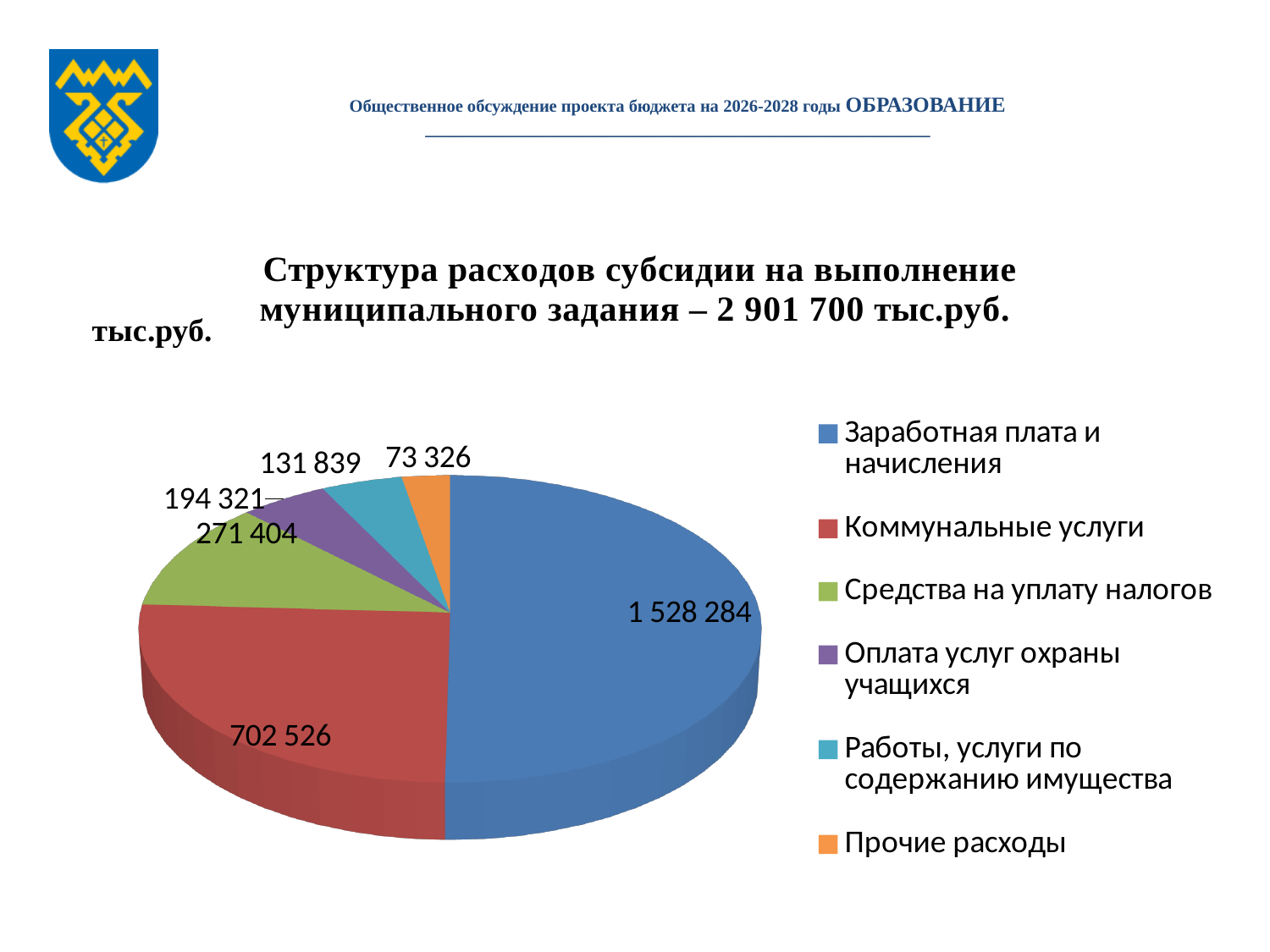
What is the difference between Заработная плата и начисления and Коммунальные услуги? 825 758 Which is larger: Оплата услуг охраны учащихся or Работы, услуги по содержанию имущества? Оплата услуг охраны учащихся What is the value for Прочие расходы? 73 326 What kind of chart is shown on the slide? Pie chart How many categories does the legend list? 6 What is the value for Заработная плата и начисления? 1 528 284 Which category has the largest slice of the pie? Заработная плата и начисления What is the value for Средства на уплату налогов? 271 404 What colour is the slice for Коммунальные услуги? Red Which category has the smallest slice of the pie? Прочие расходы What is the difference between Средства на уплату налогов and Оплата услуг охраны учащихся? 77 083 What is the value for Коммунальные услуги? 702 526